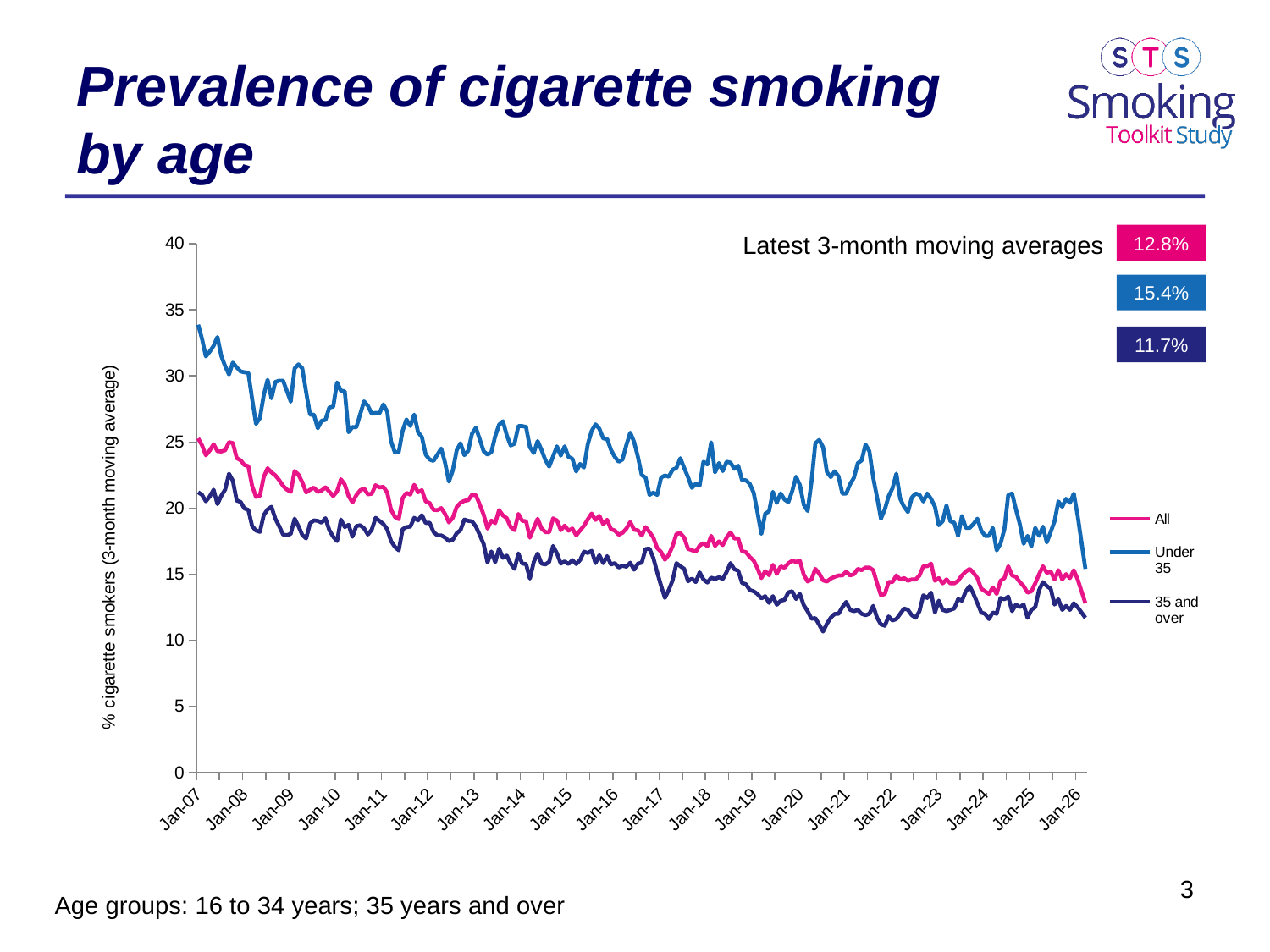
What is the latest 3-month moving average for the Under 35 series? 15.4% What is the latest 3-month moving average for the 35 and over series? 11.7% What is the latest 3-month moving average for the All series? 12.8% What is the label on the vertical axis? % cigarette smokers (3-month moving average) Is the value for Under 35 at Jan-07 greater or less than 30? greater How many series does the legend list? 3 What is the difference between the latest 3-month moving averages for Under 35 and All? 2.6 percentage points Does the Under 35 line generally rise or fall from Jan-07 to Jan-26? fall Which series has the highest latest 3-month moving average? Under 35 What kind of chart is shown on the slide? line chart What is the difference between the latest 3-month moving averages for Under 35 and 35 and over? 3.7 percentage points Which series has the lowest latest 3-month moving average? 35 and over